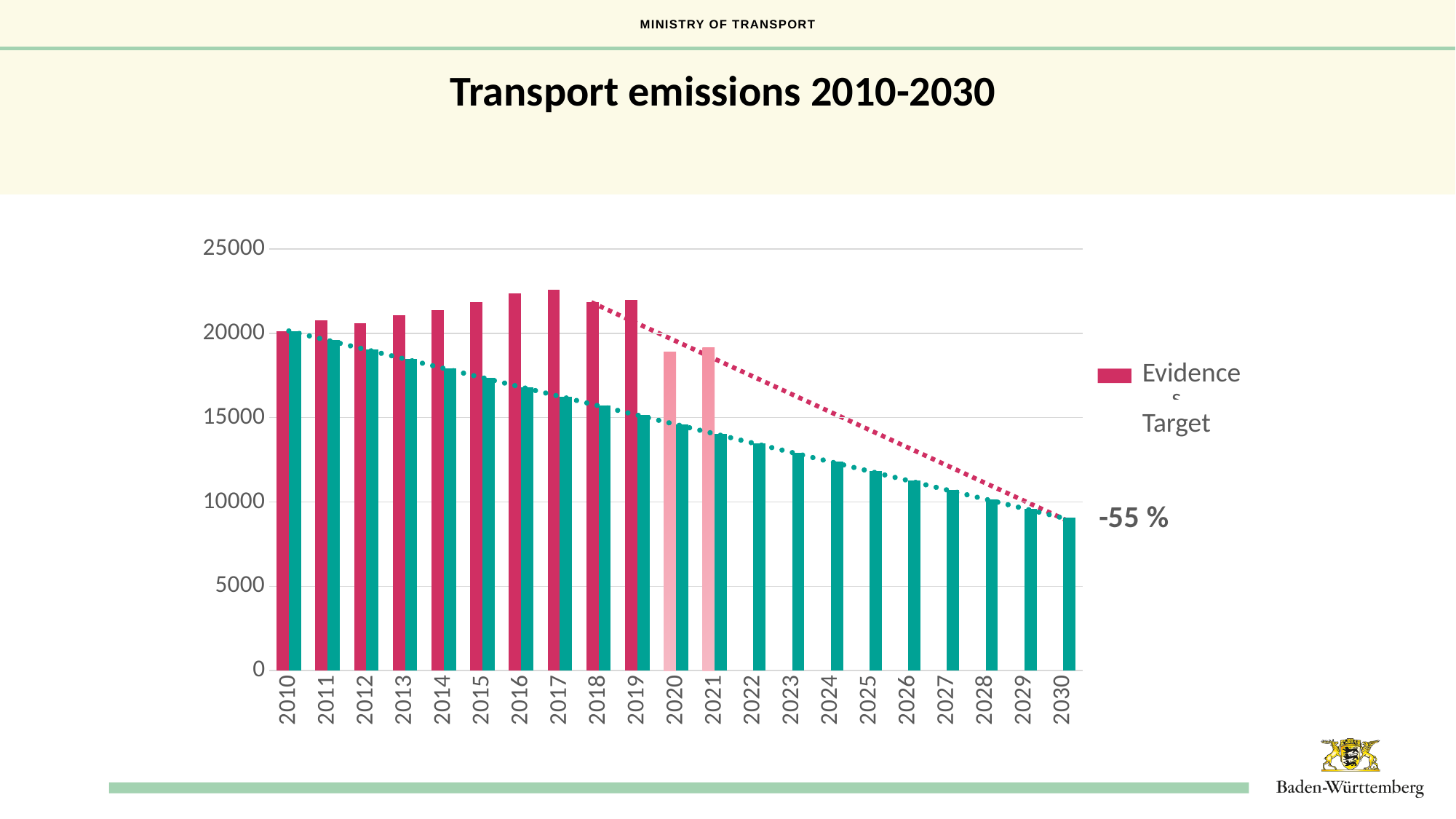
In which year is the Target value highest? 2010 Which is larger in 2019, the Evidence value or the Target value? Evidence Is the Target value for 2030 greater or less than 10000? less What percentage change is annotated at the end of the dotted lines in 2030? -55 % What kind of chart is shown on the slide? bar chart Do the Target values rise or fall from 2010 to 2030? fall In which year is the Target value lowest? 2030 Is the Target value for 2025 greater or less than 10000? greater Is the Evidence value for 2017 greater or less than 20000? greater How many years are shown on the x axis? 21 How many series does the legend list? 2